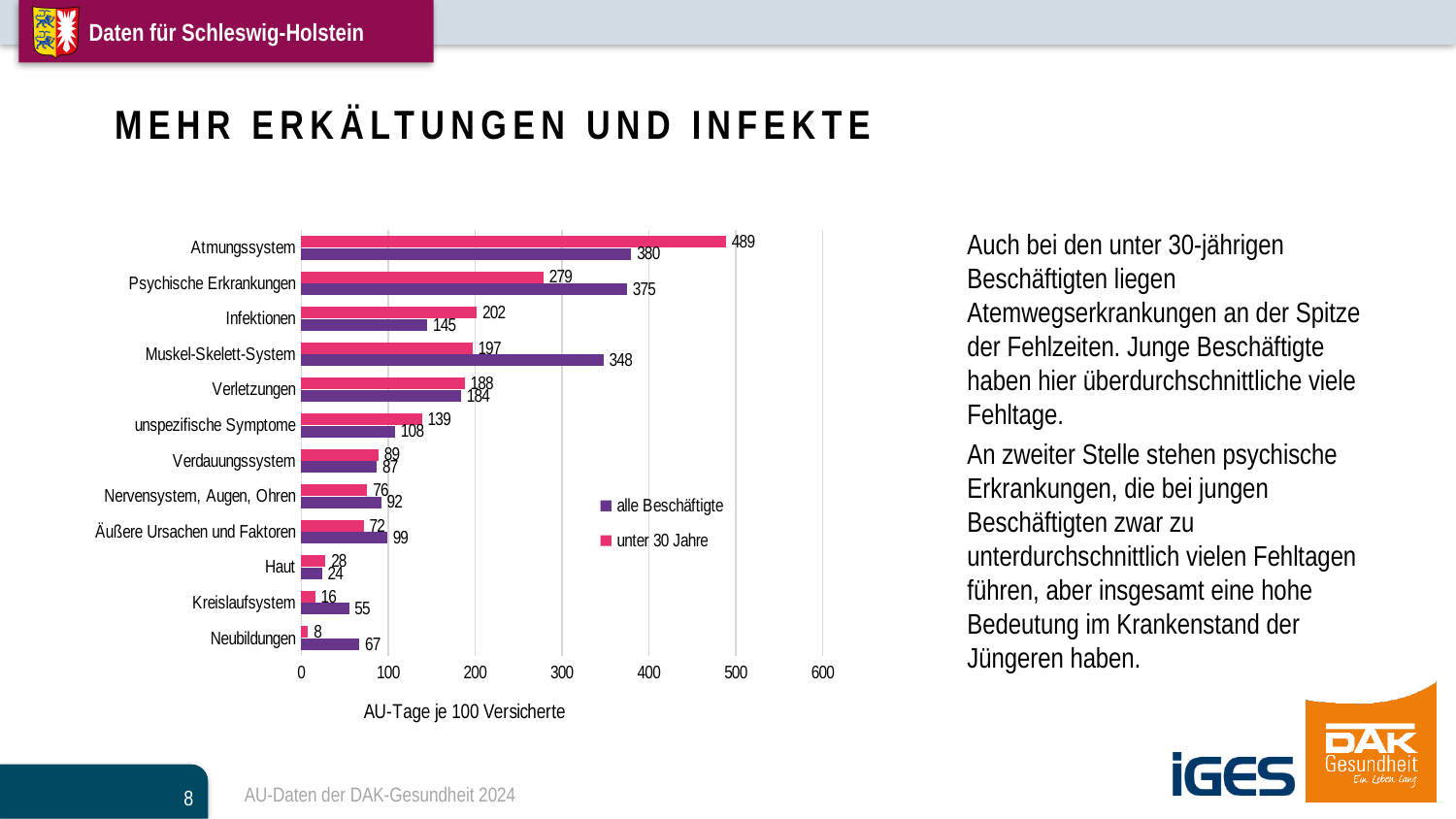
What is the difference between the 'unter 30 Jahre' and 'alle Beschäftigte' values for Atmungssystem? 109 What is the value for 'alle Beschäftigte' in the Muskel-Skelett-System category? 348 How many series does the legend list? 2 What kind of chart is shown on the slide? Bar chart Which category has the lowest value for 'unter 30 Jahre'? Neubildungen What is the value for 'unter 30 Jahre' in the Atmungssystem category? 489 What is the label of the x axis of the chart? AU-Tage je 100 Versicherte For Kreislaufsystem, which series has the larger value: 'alle Beschäftigte' or 'unter 30 Jahre'? alle Beschäftigte What is the value for 'alle Beschäftigte' in the Psychische Erkrankungen category? 375 Which category has the highest value for 'unter 30 Jahre'? Atmungssystem How many categories are shown on the chart? 12 What is the value for 'unter 30 Jahre' in the Infektionen category? 202